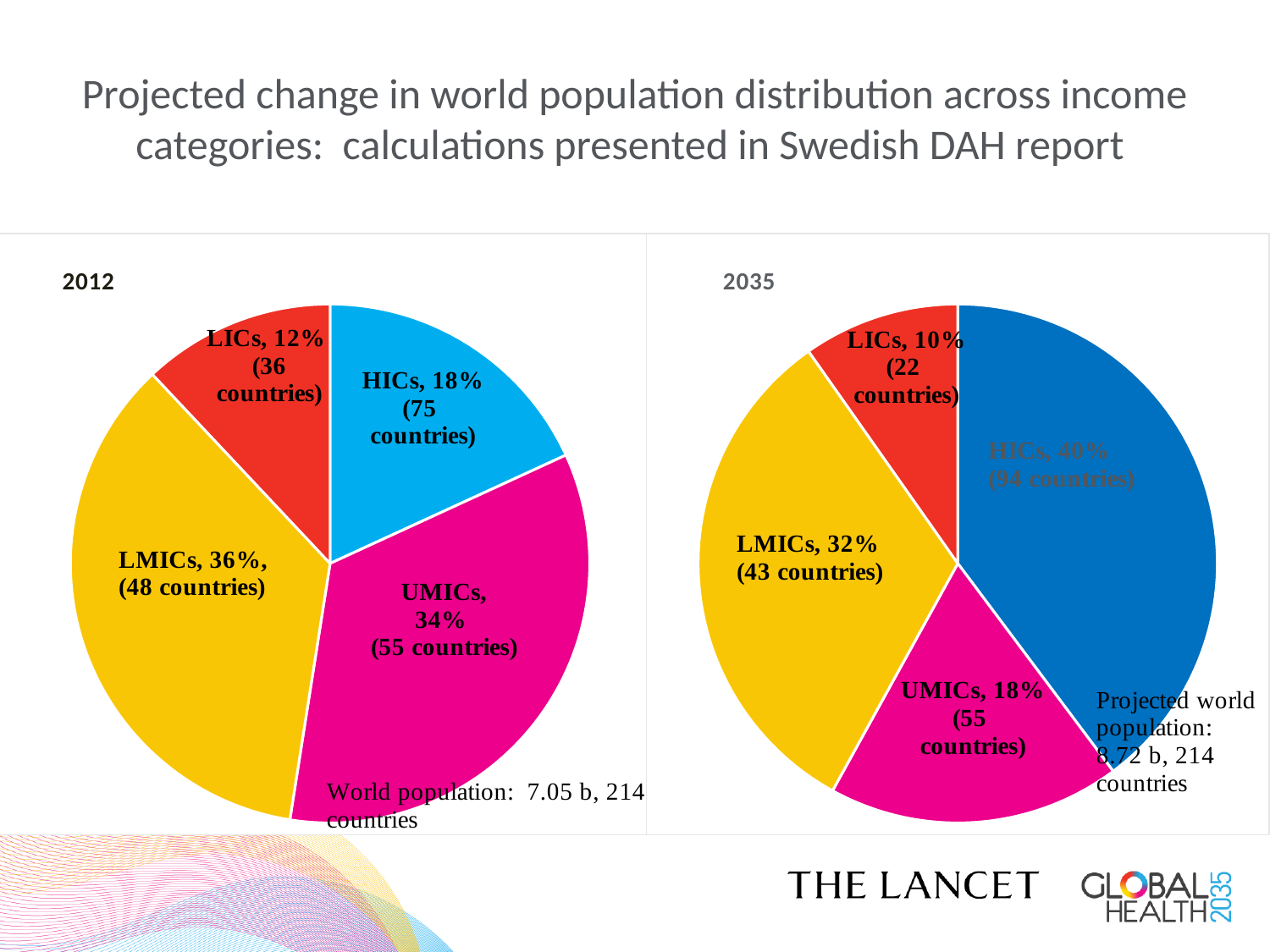
What kind of chart is the 2012 chart? pie chart What colour is the LMICs slice in the 2012 chart? yellow What is the world population stated on the 2012 chart? 7.05 b How many slices does the 2035 chart have? 4 In the 2035 chart, what share of world population is in HICs? 40% In the 2035 chart, how many countries are in the LICs category? 22 countries In the 2012 chart, what is the difference between the UMICs share and the HICs share? 16% In the 2012 chart, how many countries are in the HICs category? 75 countries In the 2035 chart, which income category has the smallest share? LICs In the 2012 chart, what share of world population is in LMICs? 36% In the 2012 chart, which income category has the largest share? LMICs In the 2035 chart, which is larger, the LMICs share or the UMICs share? LMICs